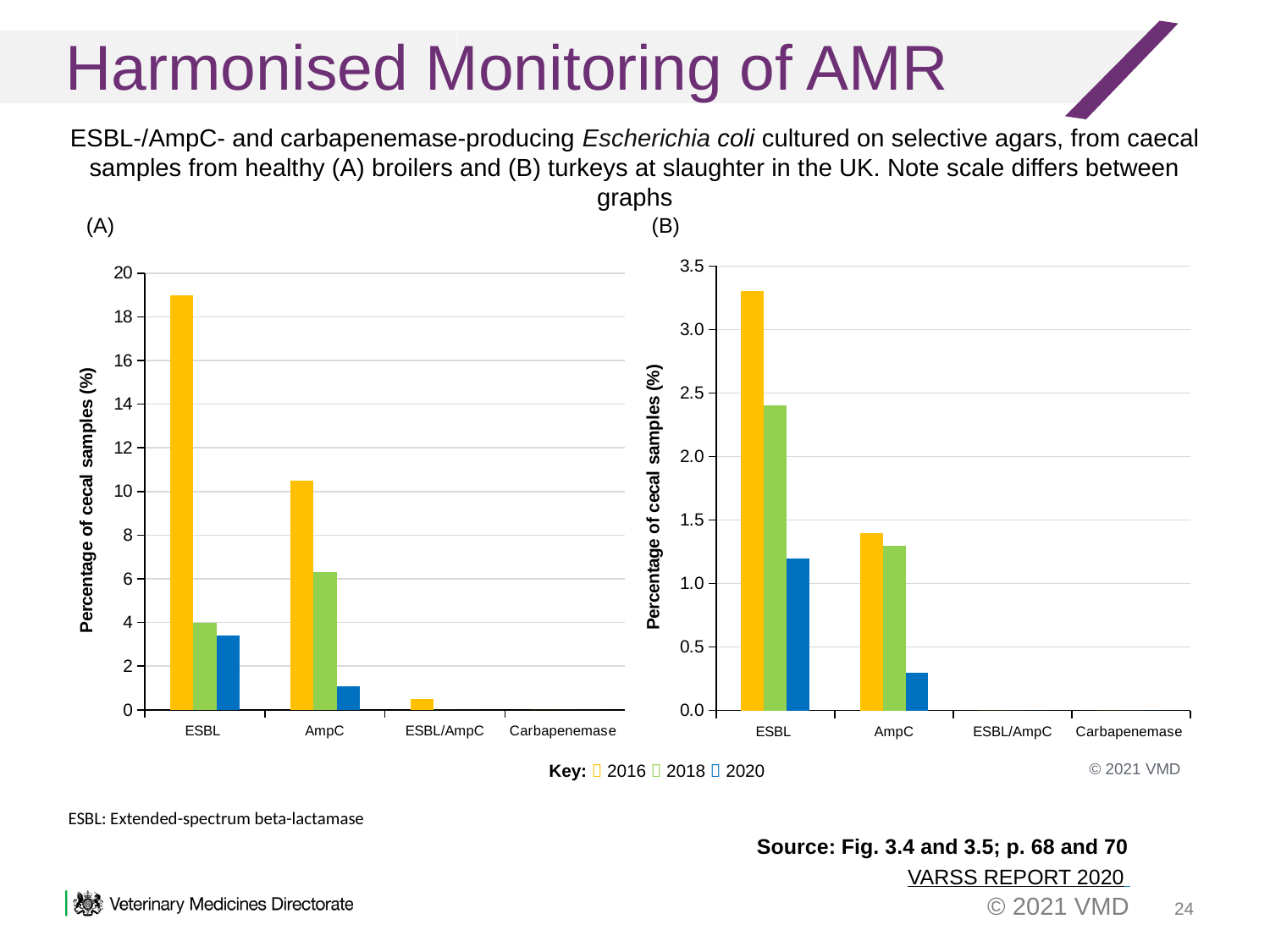
In chart (B) turkeys, is the 2016 value for ESBL greater or less than 3.0? greater What type of chart is chart (B) turkeys? bar chart In chart (B) turkeys, do the ESBL values rise or fall from 2016 to 2020? fall In chart (A) broilers, which is larger for AmpC: the 2018 value or the 2020 value? 2018 In chart (A) broilers, is the 2020 value for AmpC greater or less than 2? less In chart (A) broilers, which category has the highest 2016 value? ESBL In chart (A) broilers, is the 2016 value for AmpC greater or less than 10? greater How many years does the key list for the charts? 3 How many categories are shown on the x axis of chart (A) broilers? 4 In chart (B) turkeys, which year has the lowest value for ESBL? 2020